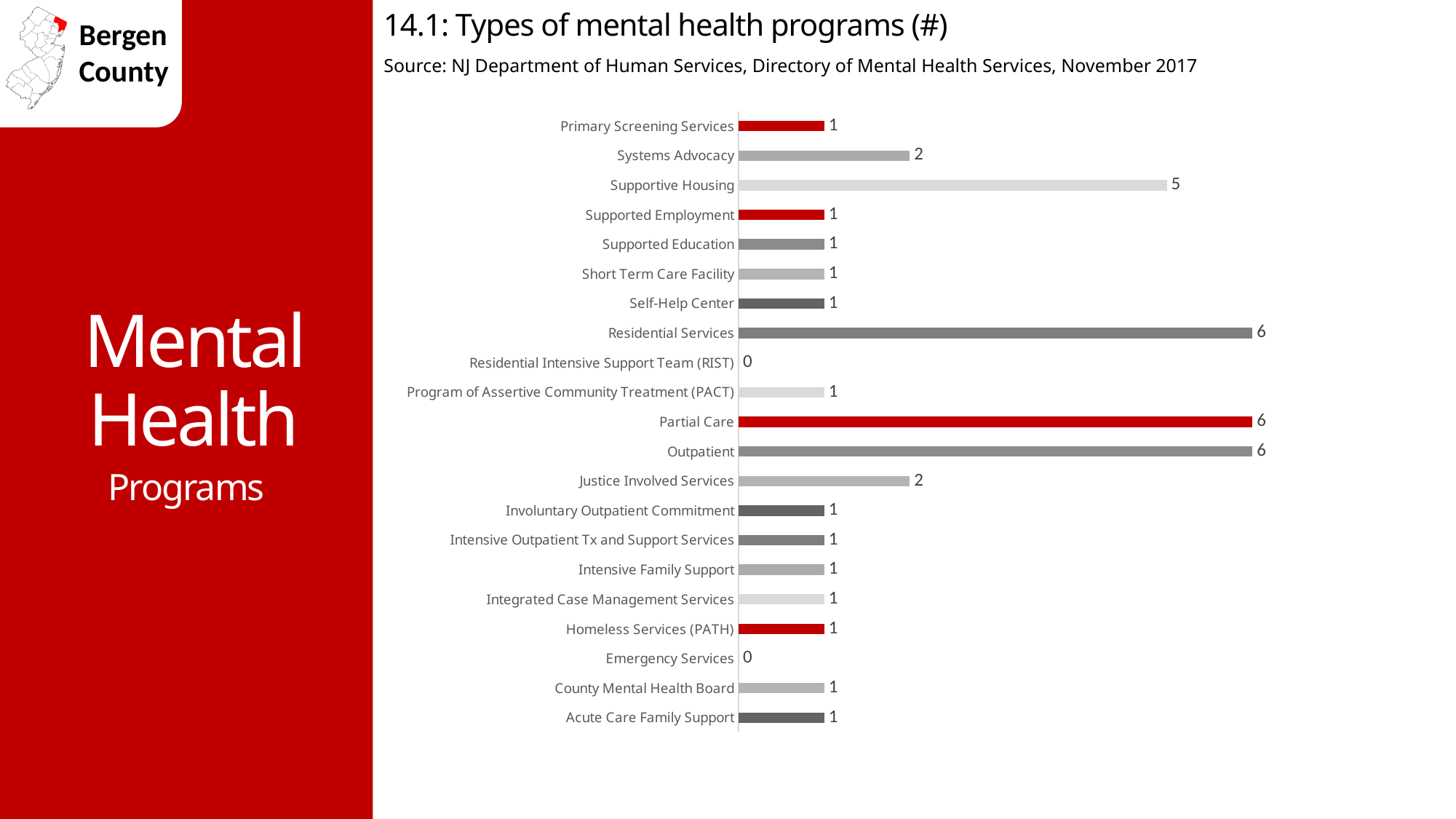
What is the difference between the values for Partial Care and Supportive Housing? 1 Which has a larger value, Supportive Housing or Systems Advocacy? Supportive Housing What is the highest value shown in the chart? 6 Which has a larger value, Emergency Services or Acute Care Family Support? Acute Care Family Support What is the difference between the values for Outpatient and Justice Involved Services? 4 How many categories are shown in the chart? 21 What is the value for Supportive Housing? 5 What kind of chart is shown on the slide? Bar chart What is the value for Homeless Services (PATH)? 1 What is the value for Systems Advocacy? 2 What is the value for Residential Services? 6 What is the value for Residential Intensive Support Team (RIST)? 0